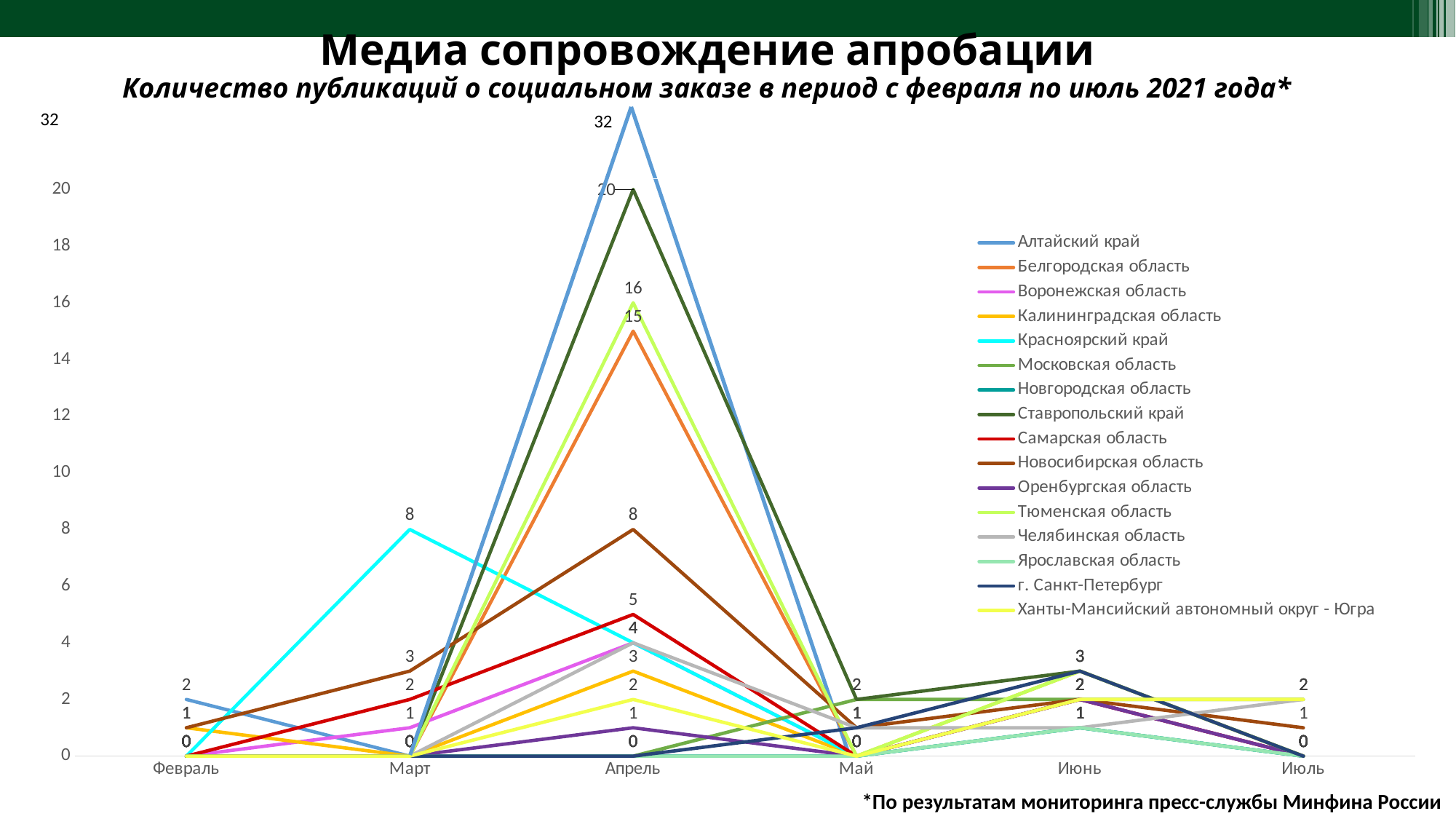
What is the value for Красноярский край in Март? 8 What is the value for Алтайский край in Апрель? 32 How many series does the legend list? 16 Is the value for Тюменская область in Апрель greater or less than 10? greater What kind of chart is shown on the slide? line chart How many months are shown on the x axis? 6 Which is larger in Апрель: Алтайский край or Ставропольский край? Алтайский край In which month does Алтайский край reach its highest value? Апрель What is the value for г. Санкт-Петербург in Июнь? 3 Does the value for Алтайский край rise or fall from Апрель to Май? fall What is the difference between Алтайский край and Ставропольский край in Апрель? 12 What is the value for Ставропольский край in Апрель? 20